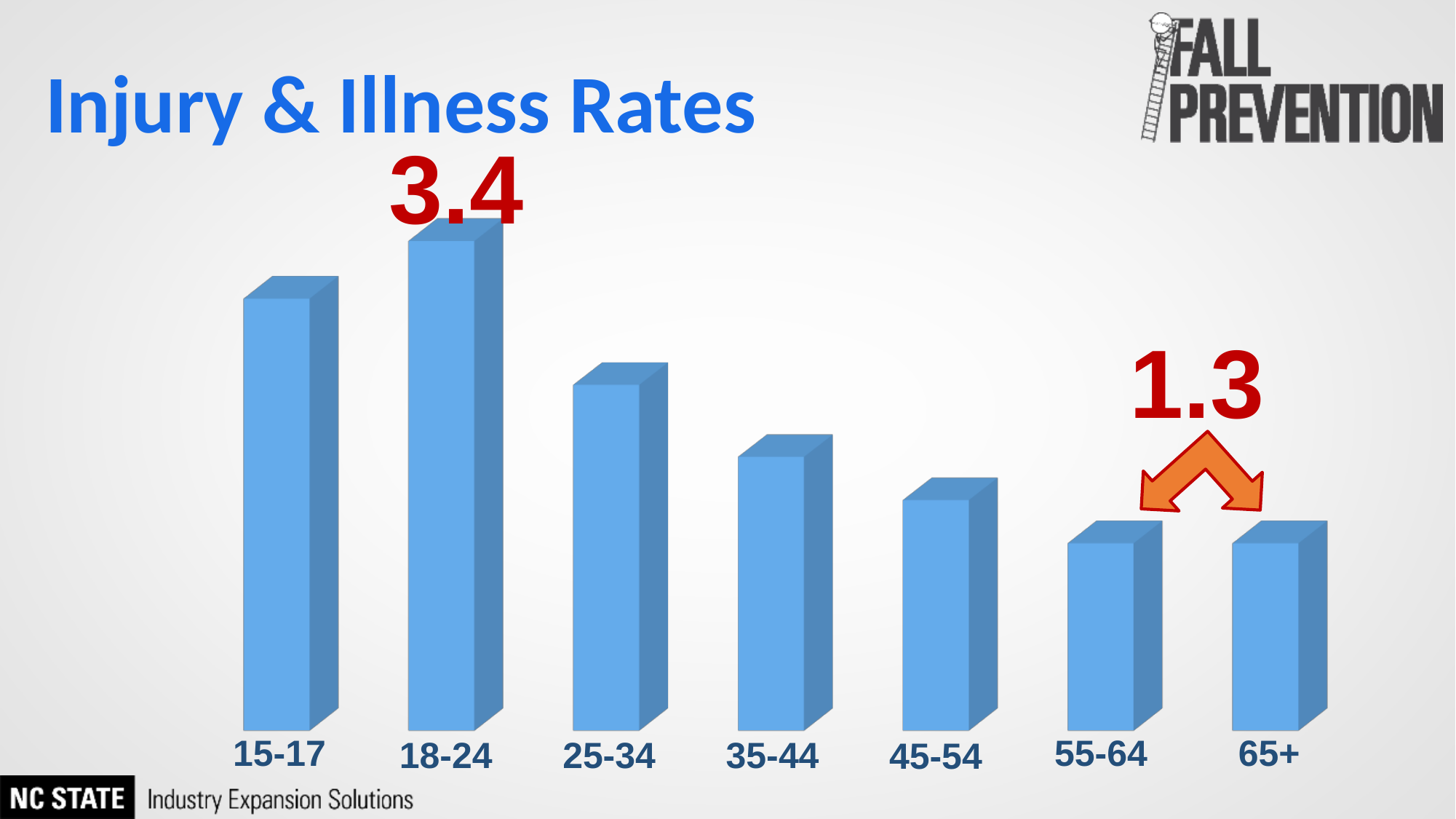
What kind of chart is shown on the slide? Bar chart What is the injury and illness rate for the 55-64 age group? 1.3 Which age group has a higher rate, 15-17 or 25-34? 15-17 From the 18-24 group onward, do the rates rise or fall as age increases? Fall Which two age groups share the lowest injury and illness rate? 55-64 and 65+ What is the title of the slide? Injury & Illness Rates Which age group has a higher rate, 35-44 or 45-54? 35-44 Which age group has the highest injury and illness rate? 18-24 How many age groups are shown in the chart? 7 What is the injury and illness rate for the 18-24 age group? 3.4 What is the difference between the rate for the 18-24 group and the rate for the 65+ group? 2.1 What is the injury and illness rate for the 65+ age group? 1.3